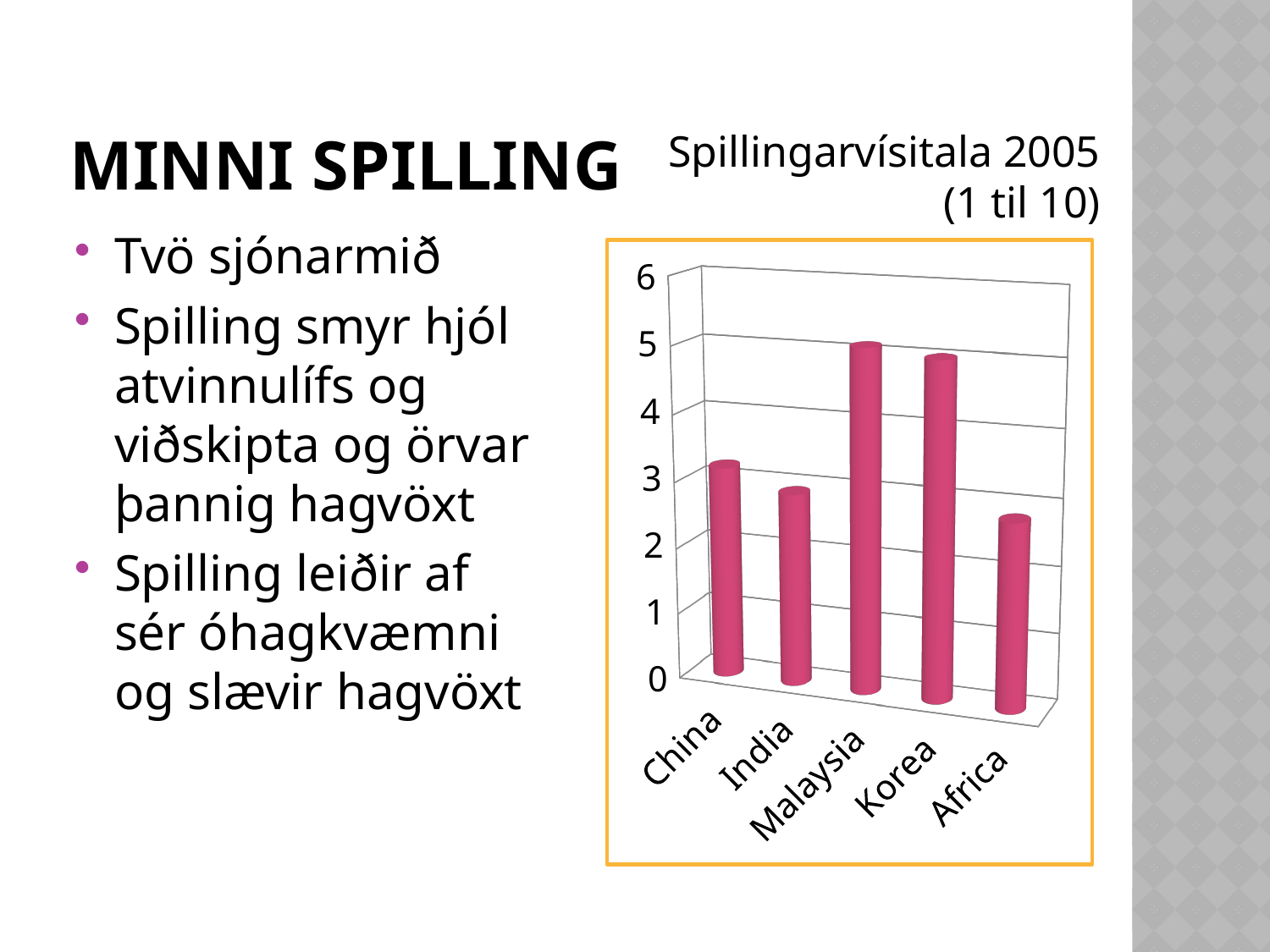
Is the value for China greater or less than 2? greater What is the highest value shown on the vertical axis of the chart? 6 What kind of chart is shown on the slide? bar chart Is the value for Africa greater or less than 3? less Which country has the lowest value in the chart? Africa Is the value for Malaysia greater or less than 4? greater Which has the larger value, Korea or Africa? Korea How many countries are shown on the x axis of the chart? 5 What is the title of the chart? Spillingarvísitala 2005 (1 til 10) Which has the larger value, Malaysia or India? Malaysia